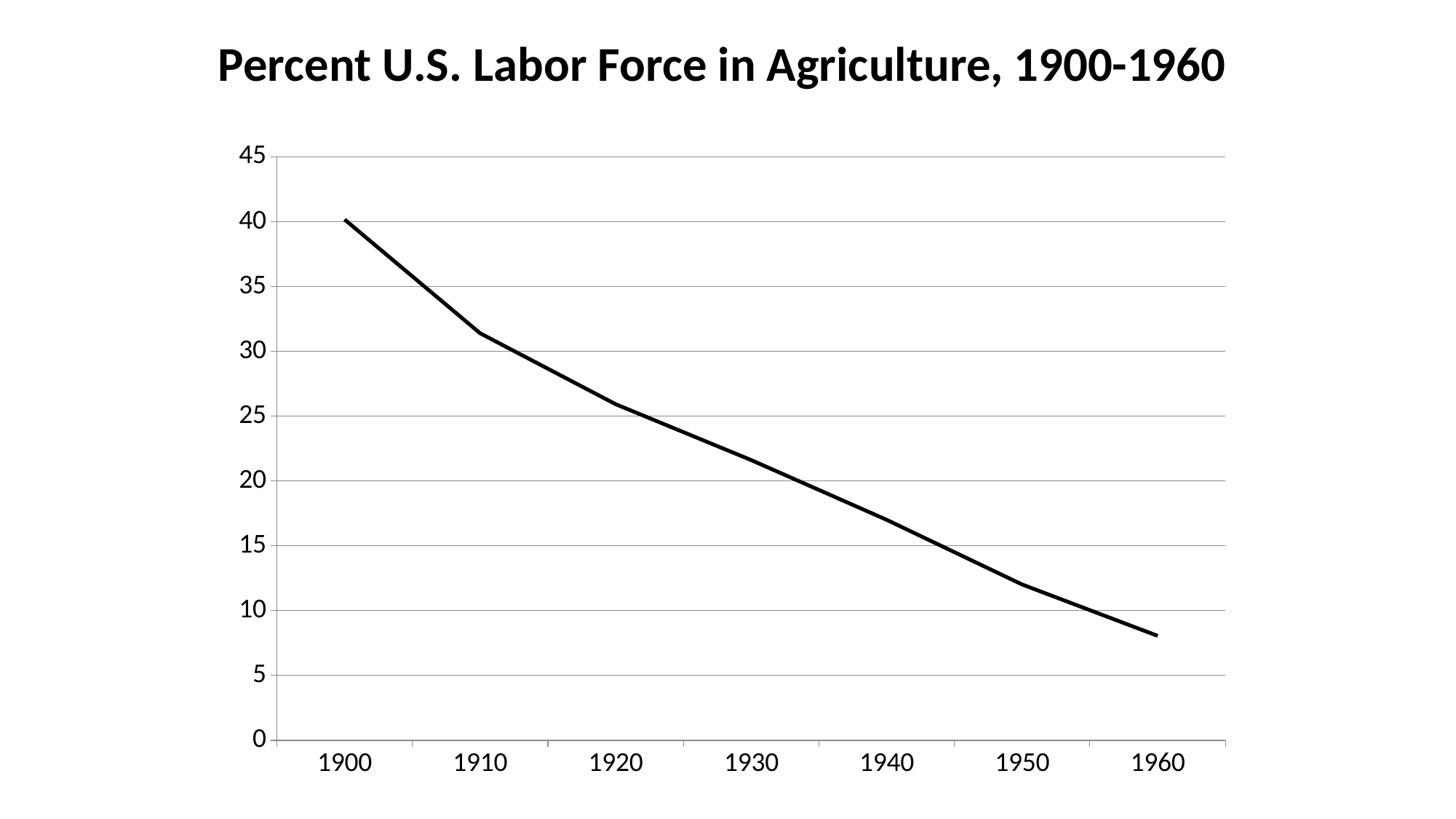
Which year has the lowest value? 1960 Is the value for 1950 greater or less than 10? greater What is the title of the chart? Percent U.S. Labor Force in Agriculture, 1900-1960 What kind of chart is shown on the slide? line chart Which is larger, the value for 1920 or the value for 1950? 1920 How many years are plotted along the x axis? 7 Do the values rise or fall from 1900 to 1960? fall Is the value for 1960 greater or less than 10? less Which year has the highest value? 1900 Is the value for 1910 greater or less than 30? greater